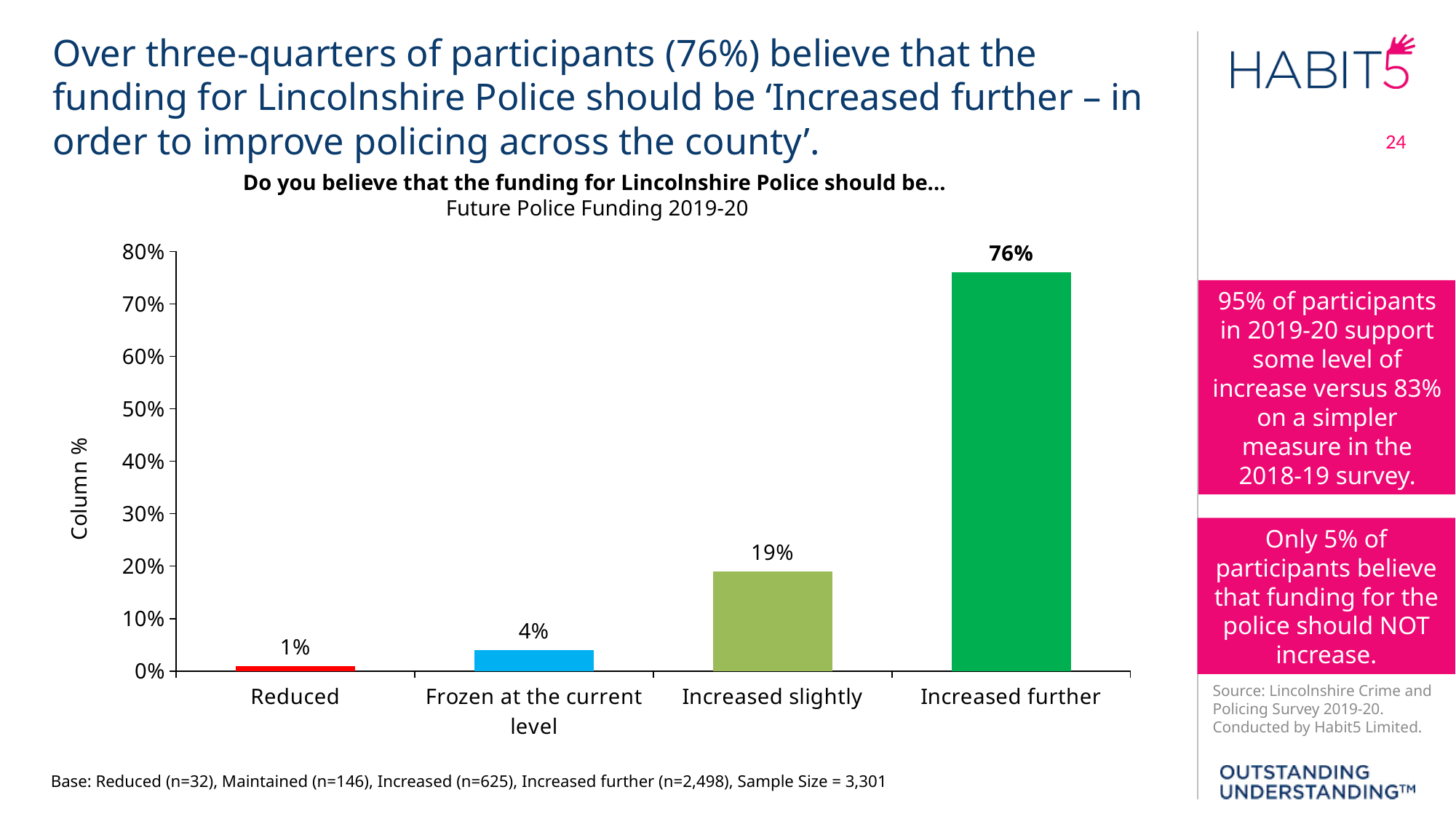
Which category has the highest value? Increased further What is the value for 'Increased slightly'? 19% Is the value for 'Increased further' greater or less than 70%? greater What is the value for 'Reduced'? 1% What percentage of participants believe funding should be 'Increased further'? 76% Which category has the lowest value? Reduced What is the difference between 'Increased further' and 'Increased slightly'? 57% What kind of chart is shown on the slide? Bar chart How many categories are shown on the x axis? 4 What is the label on the y axis of the chart? Column % Which is larger, 'Frozen at the current level' or 'Increased slightly'? Increased slightly What is the value for 'Frozen at the current level'? 4%